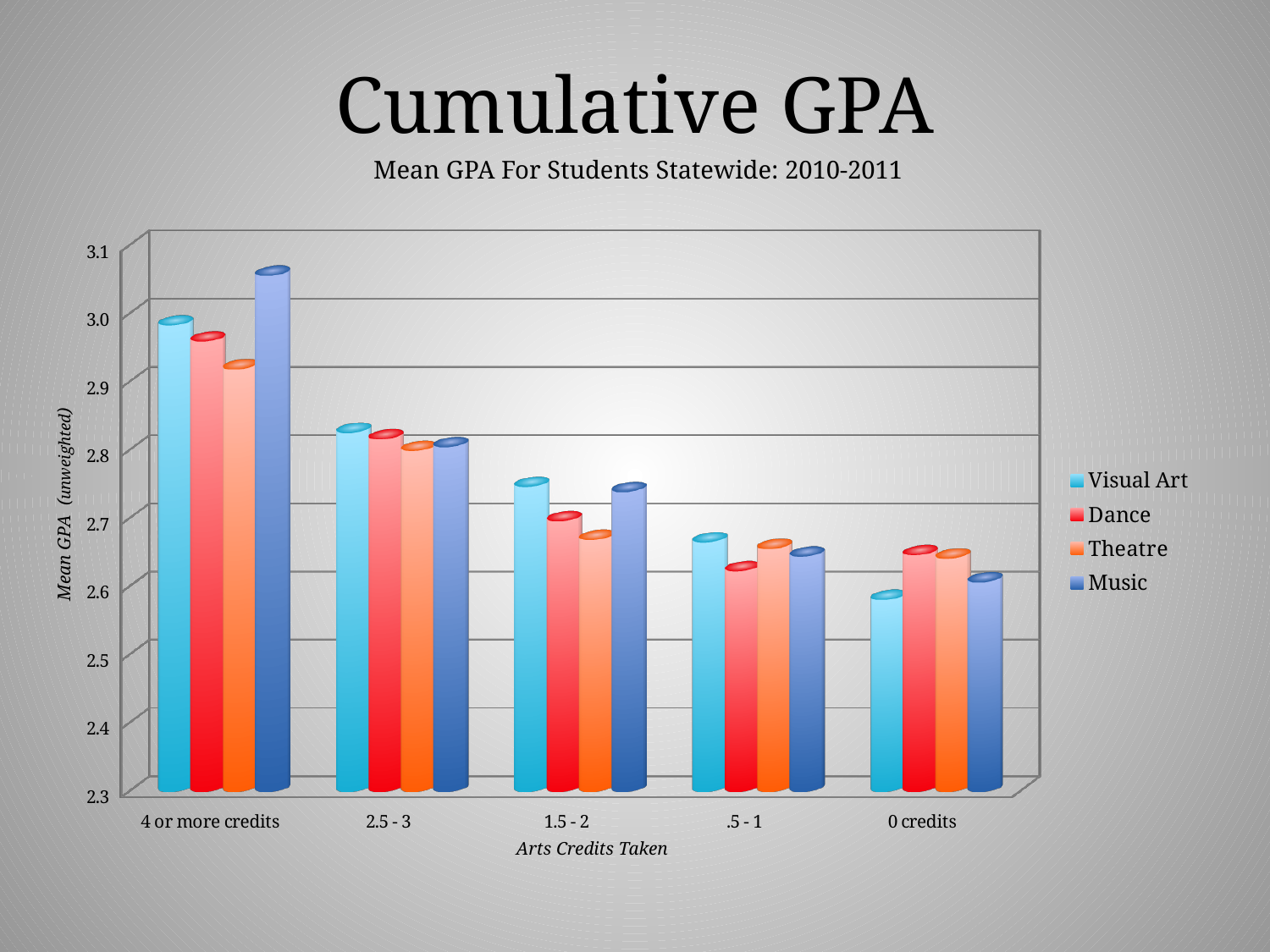
Is the Dance value for '.5 - 1' credits greater or less than 2.7? less How many arts-credit categories are shown on the x axis? 5 Do the Visual Art values rise or fall moving from '4 or more credits' to '0 credits' along the x axis? fall For the '1.5 - 2' category, which is larger: Visual Art or Theatre? Visual Art Is the Visual Art value for '0 credits' greater or less than 2.6? less Is the Music value for '4 or more credits' greater or less than 3.0? greater What kind of chart is shown on the slide? bar chart Which series has the lowest mean GPA for the '0 credits' category? Visual Art What is the title of the x axis? Arts Credits Taken What is the subtitle shown under the main title 'Cumulative GPA'? Mean GPA For Students Statewide: 2010-2011 Which series has the highest mean GPA for the '4 or more credits' category? Music How many series does the legend list? 4